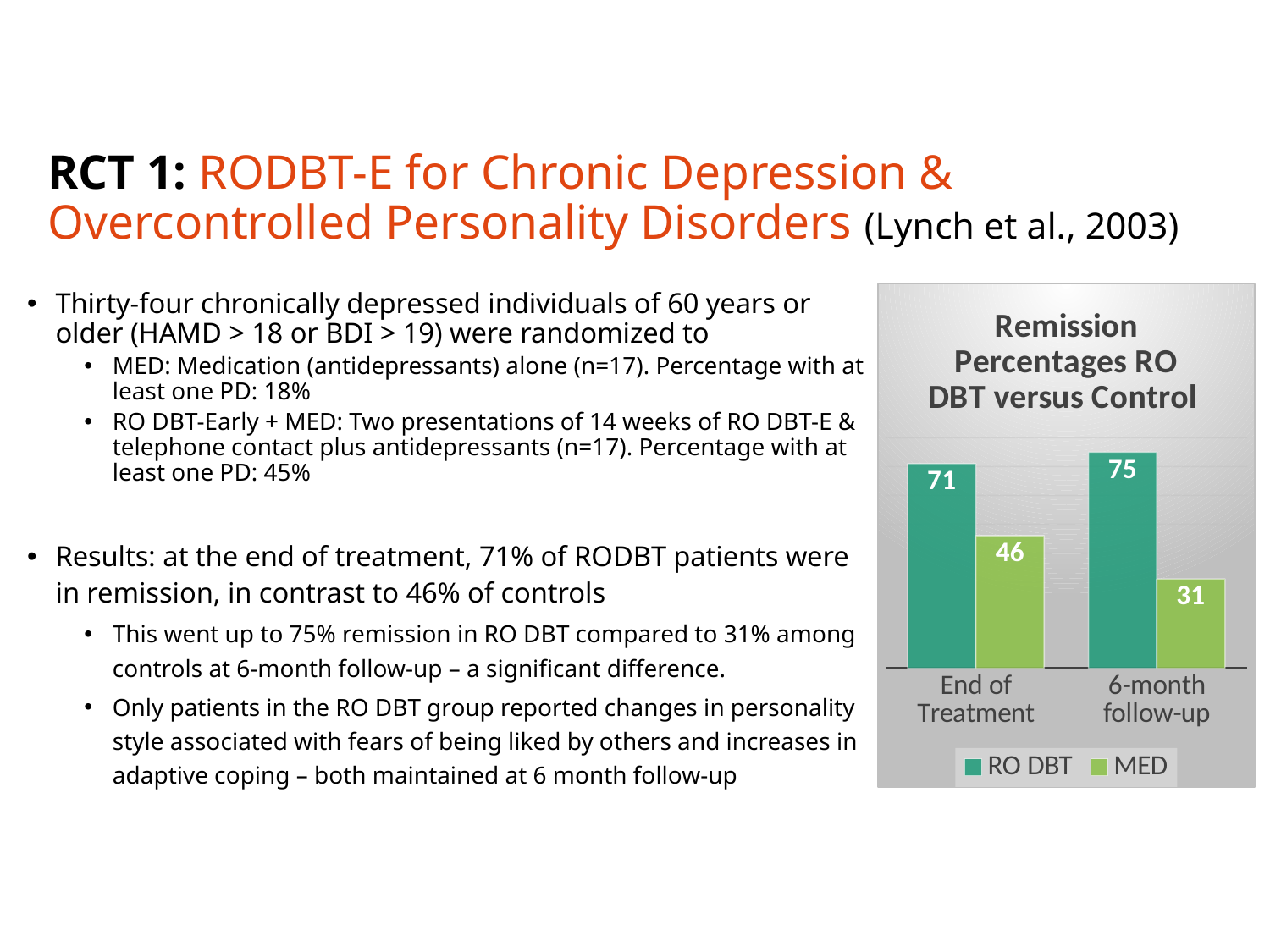
What kind of chart is shown on the slide? Bar chart Which is larger at 6-month follow-up, RO DBT or MED? RO DBT How many categories are shown on the x axis? 2 Which bar has the highest value in the chart? RO DBT at 6-month follow-up What is the RO DBT value at 6-month follow-up? 75 What is the difference between the RO DBT and MED values at End of Treatment? 25 What is the MED value at 6-month follow-up? 31 What is the difference between the RO DBT and MED values at 6-month follow-up? 44 Which bar has the lowest value in the chart? MED at 6-month follow-up What is the MED value at End of Treatment? 46 What is the RO DBT value at End of Treatment? 71 How many series does the legend list? 2